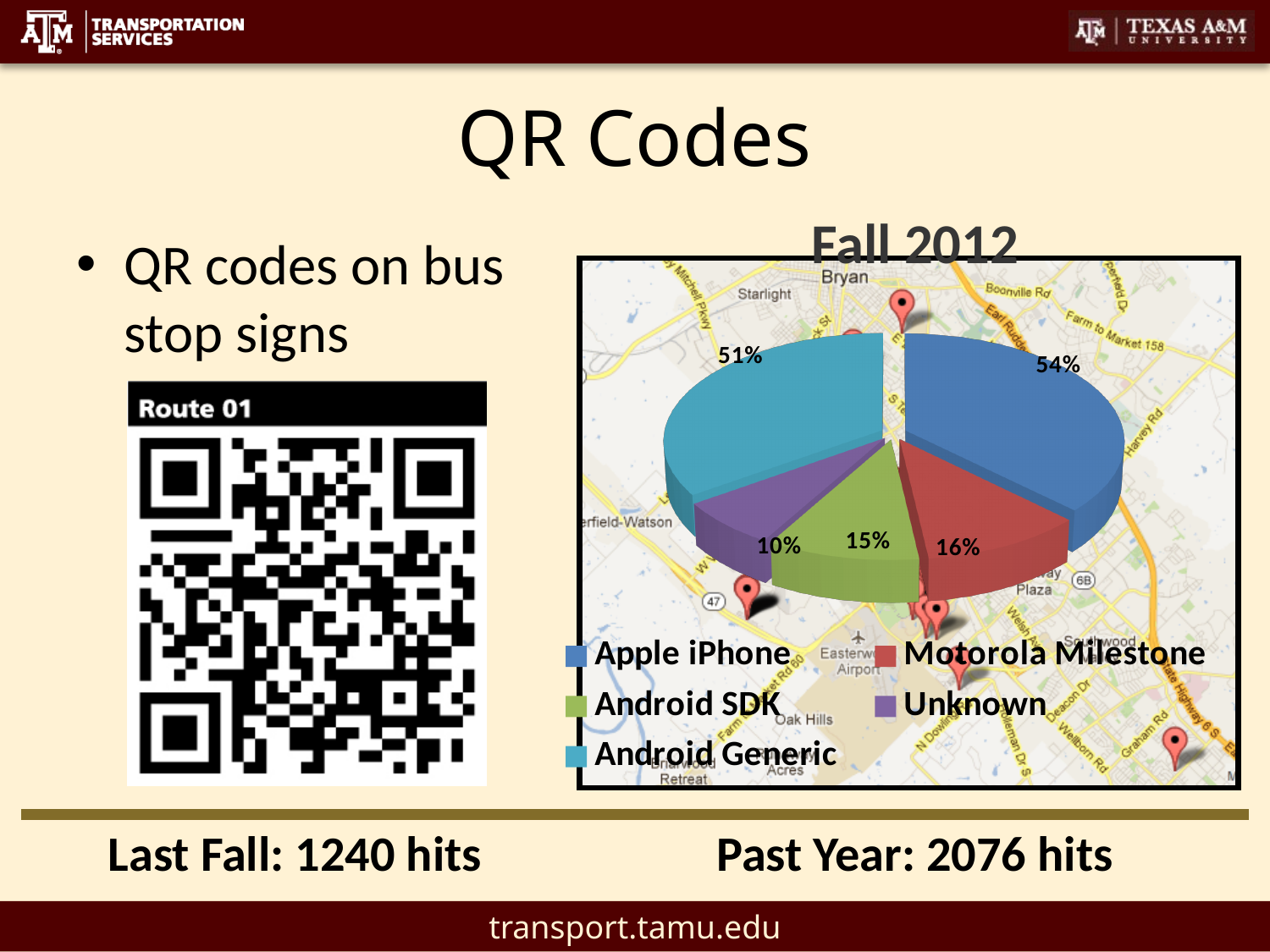
Which slice is larger in the pie chart, Motorola Milestone or Unknown? Motorola Milestone How many slices does the pie chart have? 5 What is the title of the pie chart? Fall 2012 How many entries does the legend of the pie chart list? 5 What percentage is labelled on the Unknown slice of the pie chart? 10% Which category has the smallest slice in the pie chart? Unknown What colour is the Android Generic slice in the pie chart? light blue What percentage is labelled on the Android SDK slice of the pie chart? 15% What percentage is labelled on the Motorola Milestone slice of the pie chart? 16% What kind of chart is shown on the slide? pie chart What percentage is labelled on the Apple iPhone slice of the pie chart? 54% Which category has the largest slice in the pie chart? Apple iPhone